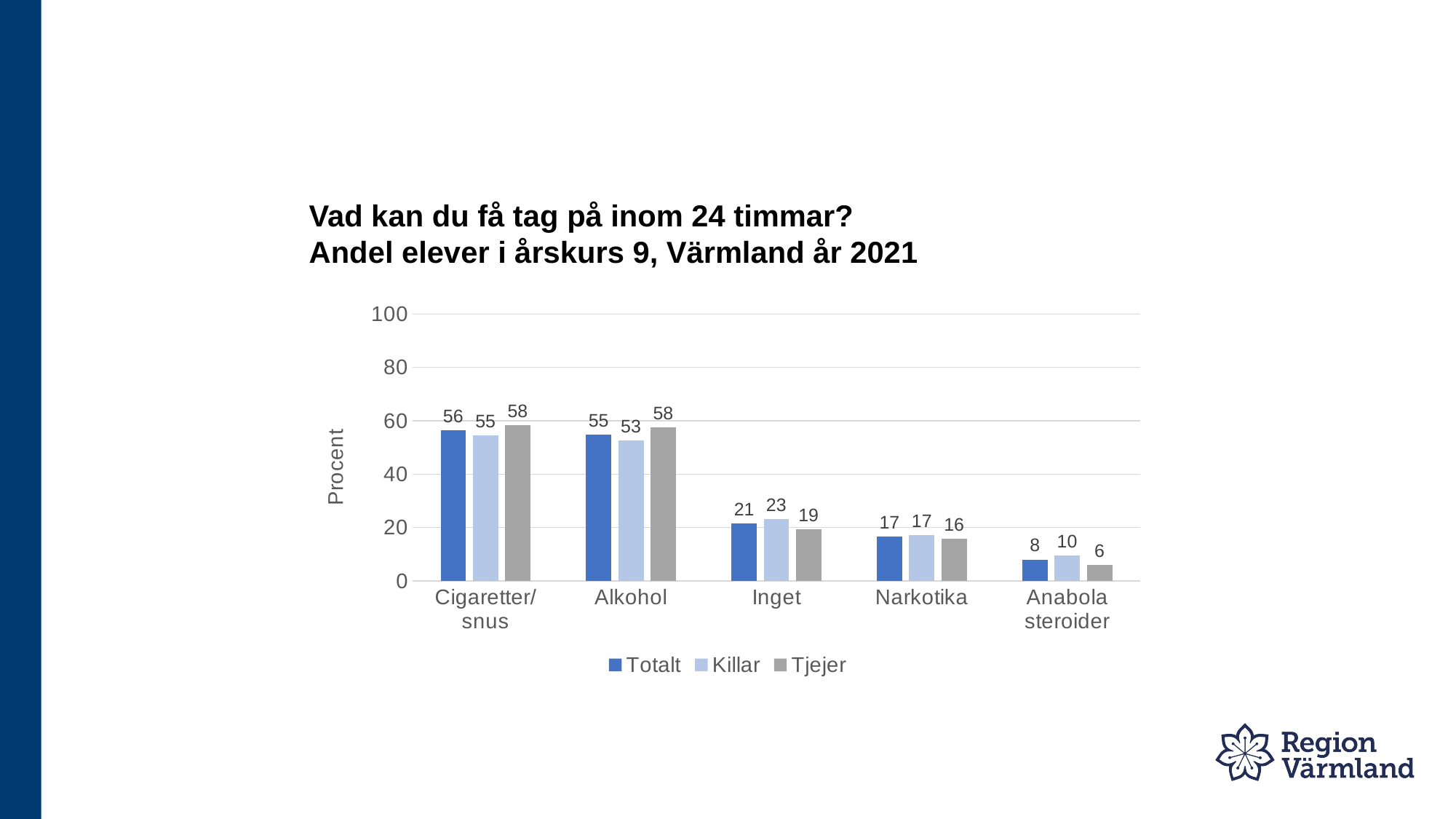
What is the Totalt value for Alkohol? 55 Which category has the highest Killar value? Cigaretter/snus How many categories are shown on the x axis? 5 What kind of chart is shown on the slide? bar chart Which is larger for Inget: the Killar value or the Tjejer value? Killar How many series does the legend list? 3 What is the Tjejer value for Anabola steroider? 6 What is the label of the y axis? Procent Which category has the lowest Totalt value? Anabola steroider What is the difference between the Tjejer and Killar values for Alkohol? 5 Is the Totalt value for Narkotika greater or less than 20? less What is the Killar value for Inget? 23